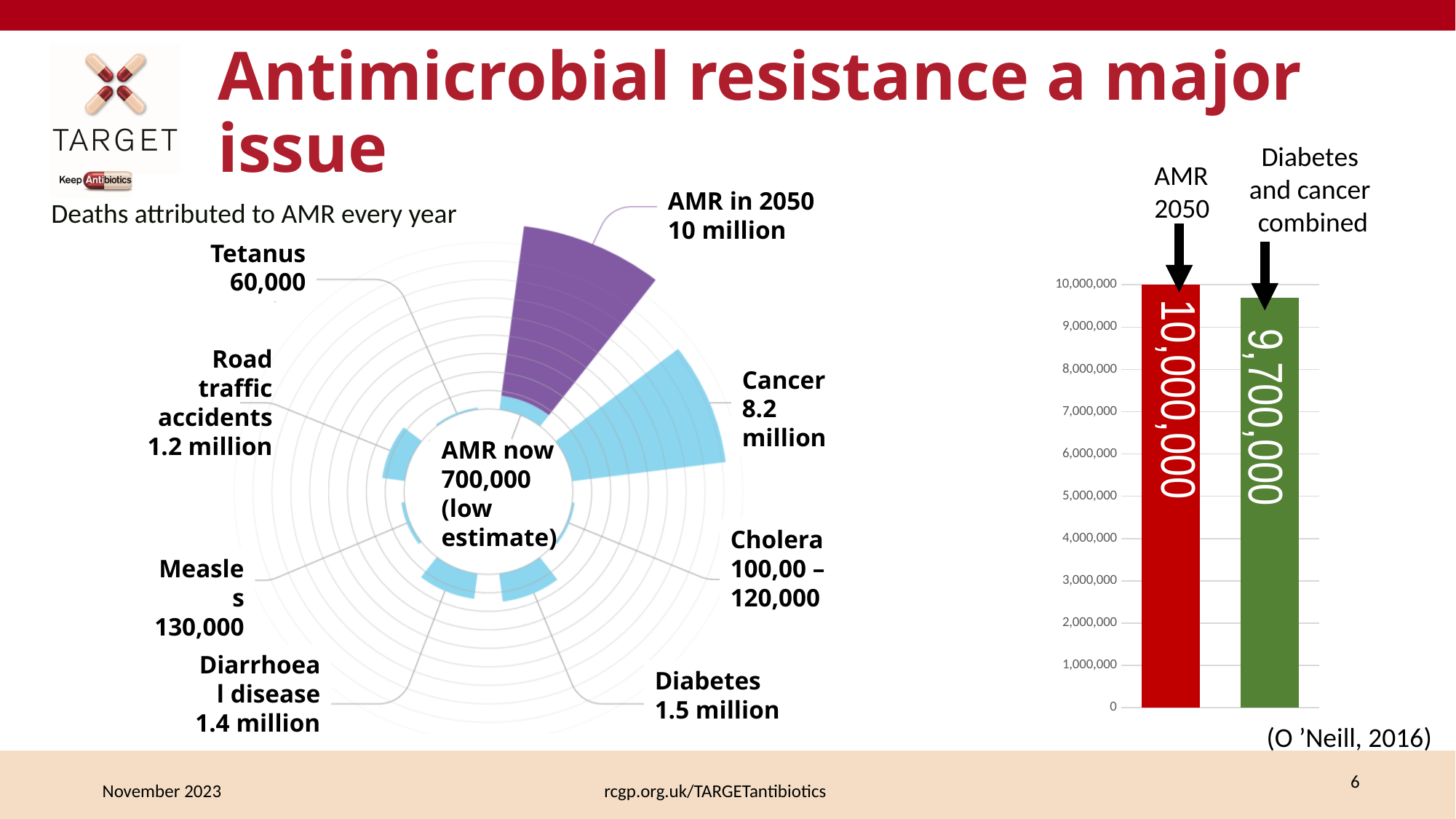
In the bar chart on the right, what is the difference between the AMR 2050 bar and the diabetes and cancer combined bar? 300,000 What type of chart is shown on the right of the slide? Bar chart In the 'Deaths attributed to AMR every year' chart, how many deaths are attributed to cancer? 8.2 million In the bar chart on the right, what value is shown for AMR 2050? 10,000,000 In the 'Deaths attributed to AMR every year' chart, what is the low estimate for AMR deaths now? 700,000 In the 'Deaths attributed to AMR every year' chart, which has more deaths: diabetes or diarrhoeal disease? Diabetes In the 'Deaths attributed to AMR every year' chart, how many deaths are attributed to tetanus? 60,000 In the bar chart on the right, what value is shown for diabetes and cancer combined? 9,700,000 In the bar chart on the right, what colour is the AMR 2050 bar? Red In the 'Deaths attributed to AMR every year' chart, what is the difference between measles deaths and tetanus deaths? 70,000 In the bar chart on the right, which bar is taller: AMR 2050 or diabetes and cancer combined? AMR 2050 How many bars are in the bar chart on the right? 2